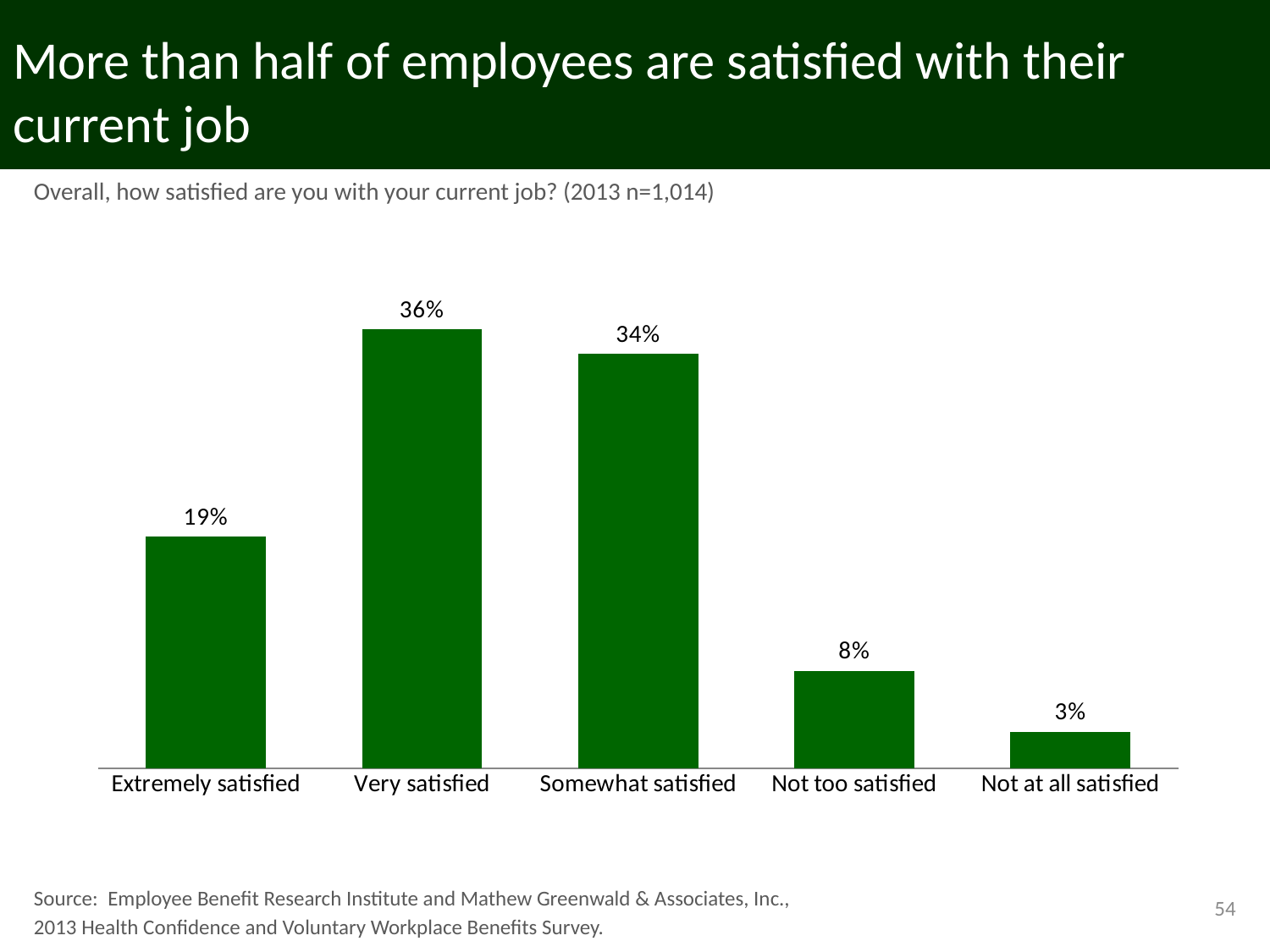
What percentage of employees are very satisfied with their current job? 36% What percentage of employees are extremely satisfied with their current job? 19% Which category has the lowest value? Not at all satisfied How many categories are shown on the chart? 5 Which is larger, the value for Extremely satisfied or the value for Not too satisfied? Extremely satisfied What is the value for Not at all satisfied? 3% What is the value for Not too satisfied? 8% Which category has the highest value? Very satisfied What is the difference between the Extremely satisfied and Not too satisfied values? 11% What survey question is the chart based on, as shown above the chart? Overall, how satisfied are you with your current job? (2013 n=1,014) What is the difference between the Very satisfied and Somewhat satisfied values? 2% What kind of chart is shown on the slide? Bar chart